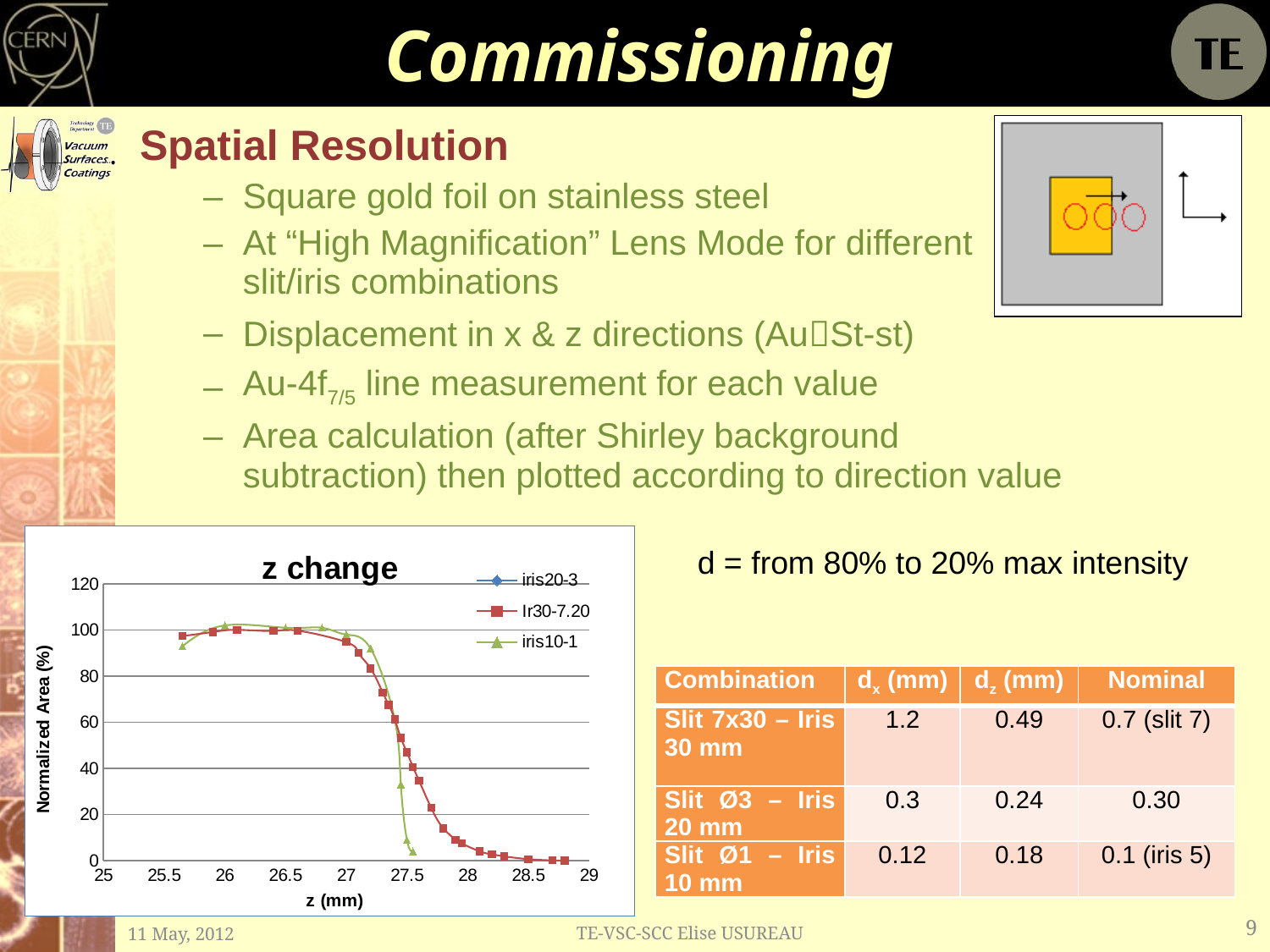
What is the label of the x axis of the chart? z (mm) What is the label of the y axis of the chart? Normalized Area (%) How many series does the chart's legend list? 3 What type of chart is shown on the slide? line chart What is the maximum value shown on the y axis of the chart? 120 What is the title of the chart on the slide? z change Is the value of the iris10-1 series at z = 27.5 mm greater or less than 40? less What is the maximum value shown on the x axis of the chart? 29 Is the value of the Ir30-7.20 series at z = 26 mm greater or less than 80? greater Is the value of the Ir30-7.20 series at z = 28.5 mm greater or less than 20? less What are the series names listed in the chart's legend? iris20-3, Ir30-7.20, iris10-1 Do the plotted values rise or fall as z increases from 27 mm to 28.5 mm? fall